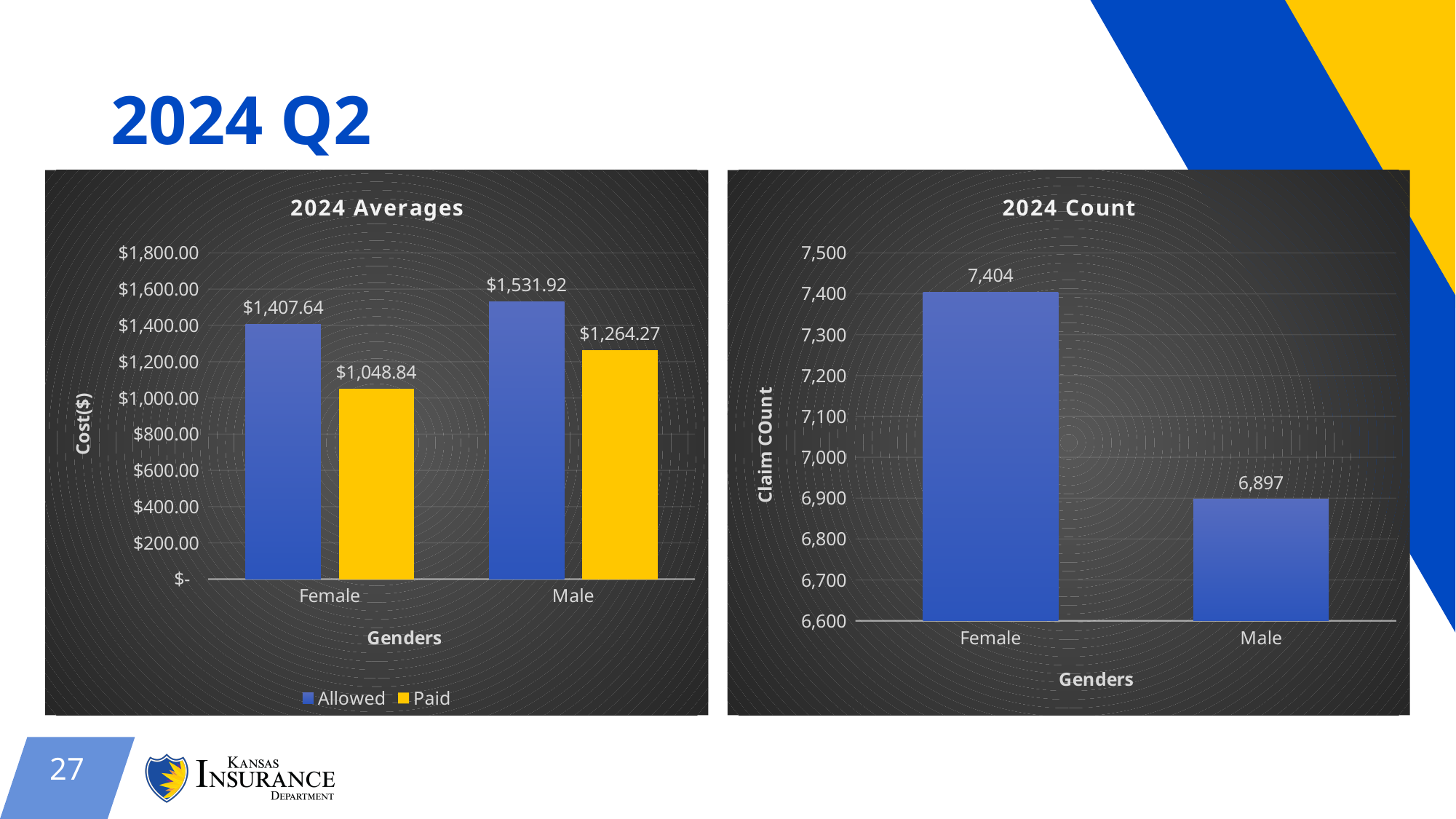
In the 2024 Averages chart, what is the Paid value for Female? $1,048.84 In the 2024 Count chart, which gender has the lowest claim count? Male In the 2024 Averages chart, what is the Allowed value for Female? $1,407.64 In the 2024 Averages chart, what is the Paid value for Male? $1,264.27 In the 2024 Averages chart, what is the difference between the Allowed and Paid values for Male? $267.65 What kind of chart is the 2024 Count chart? Bar chart What is the y-axis label of the 2024 Averages chart? Cost($) In the 2024 Count chart, what is the claim count for Female? 7,404 How many series does the legend of the 2024 Averages chart list? 2 In the 2024 Averages chart, which is larger: the Allowed value for Female or the Paid value for Male? Allowed value for Female In the 2024 Count chart, what is the difference between the Female and Male claim counts? 507 In the 2024 Averages chart, which bar has the highest value? Male Allowed